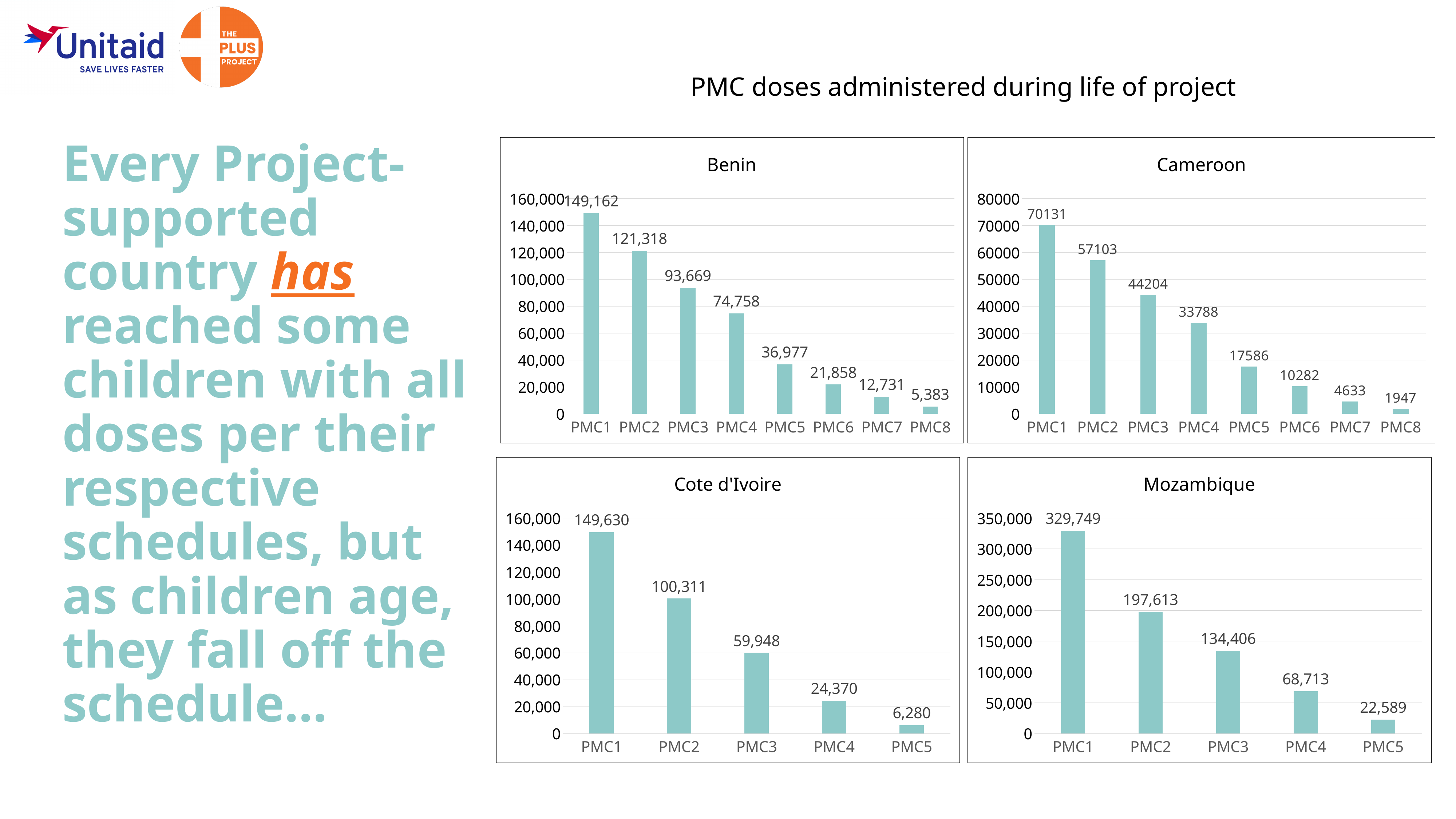
In the Cameroon chart, what is the value for PMC4? 33788 What kind of chart is the Cameroon chart? bar chart In the Benin chart, what is the difference between the values for PMC1 and PMC2? 27,844 In the Cote d'Ivoire chart, which is larger, the value for PMC2 or the value for PMC3? PMC2 How many categories does the Mozambique chart show? 5 In the Mozambique chart, which category has the highest value? PMC1 In the Benin chart, what is the value for PMC1? 149,162 In the Cameroon chart, which category has the lowest value? PMC8 In the Mozambique chart, what is the value for PMC5? 22,589 How many categories does the Benin chart show? 8 In the Cote d'Ivoire chart, what is the value for PMC3? 59,948 In the Cote d'Ivoire chart, do the values rise or fall from PMC1 to PMC5? fall